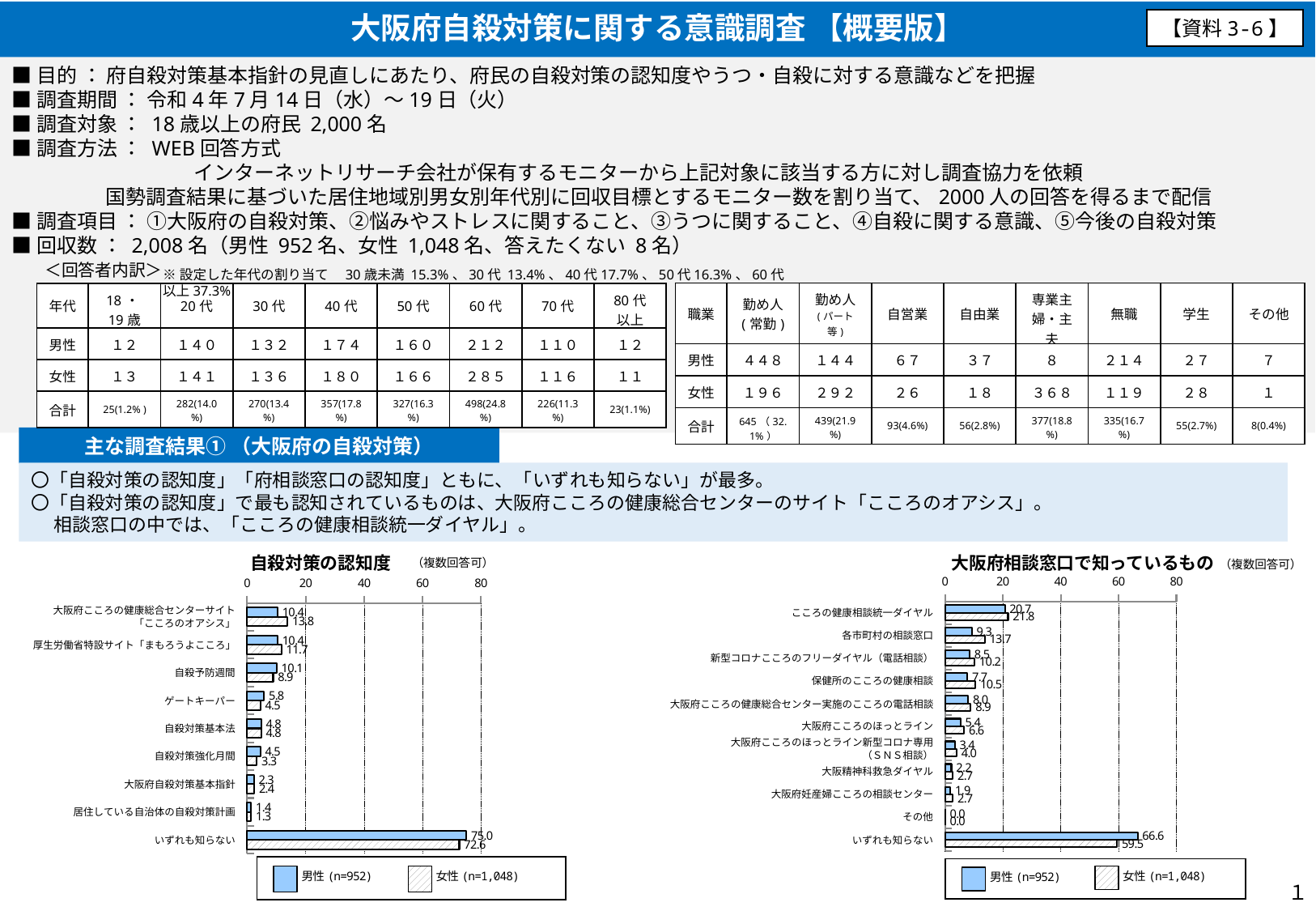
In the chart titled 大阪府相談窓口で知っているもの, what is the value for 女性 for こころの健康相談統一ダイヤル? 21.8 In the chart titled 自殺対策の認知度, what is the value for 男性 for いずれも知らない? 75.0 In the chart titled 自殺対策の認知度, what kind of chart is it? Bar chart In the chart titled 自殺対策の認知度, which category has the lowest 女性 value? 居住している自治体の自殺対策計画 In the chart titled 大阪府相談窓口で知っているもの, which is larger for 各市町村の相談窓口, the 男性 value or the 女性 value? 女性 In the chart titled 自殺対策の認知度, what is the value for 女性 for 大阪府こころの健康総合センターサイト「こころのオアシス」? 13.8 In the chart titled 自殺対策の認知度, what is the difference between the 男性 and 女性 values for いずれも知らない? 2.4 In the chart titled 大阪府相談窓口で知っているもの, which category has the highest 男性 value? いずれも知らない In the chart titled 大阪府相談窓口で知っているもの, how many series does the legend list? 2 In the chart titled 自殺対策の認知度, how many categories are shown on the vertical axis? 9 In the chart titled 大阪府相談窓口で知っているもの, what is the value for 男性 for いずれも知らない? 66.6 In the chart titled 大阪府相談窓口で知っているもの, what is the difference between the 男性 and 女性 values for いずれも知らない? 7.1